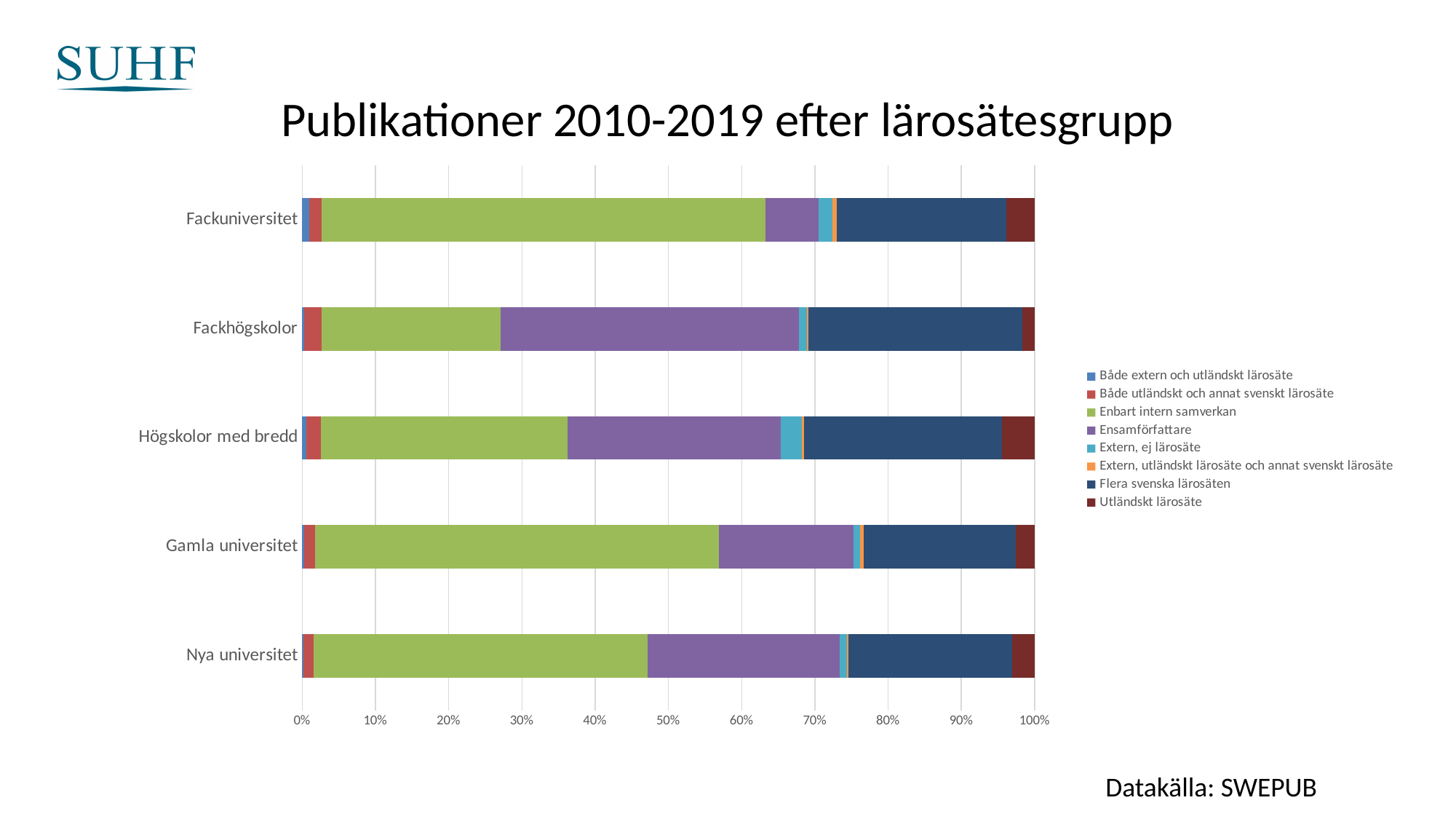
Is the 'Enbart intern samverkan' share for Gamla universitet greater or less than 50%? greater How many series does the legend list? 8 Which has a larger share of 'Utländskt lärosäte': Högskolor med bredd or Fackhögskolor? Högskolor med bredd Is the 'Enbart intern samverkan' share for Fackhögskolor greater or less than 30%? less Which category has the smallest share of 'Enbart intern samverkan'? Fackhögskolor What kind of chart is shown on the slide? Stacked bar chart Which category has the largest share of 'Ensamförfattare'? Fackhögskolor Which has a larger share of 'Ensamförfattare': Fackhögskolor or Fackuniversitet? Fackhögskolor Which category has the largest share of 'Enbart intern samverkan'? Fackuniversitet What does each stacked bar total on the x axis? 100% How many institution groups (categories) are shown on the y axis? 5 What is the title of the chart? Publikationer 2010-2019 efter lärosätesgrupp